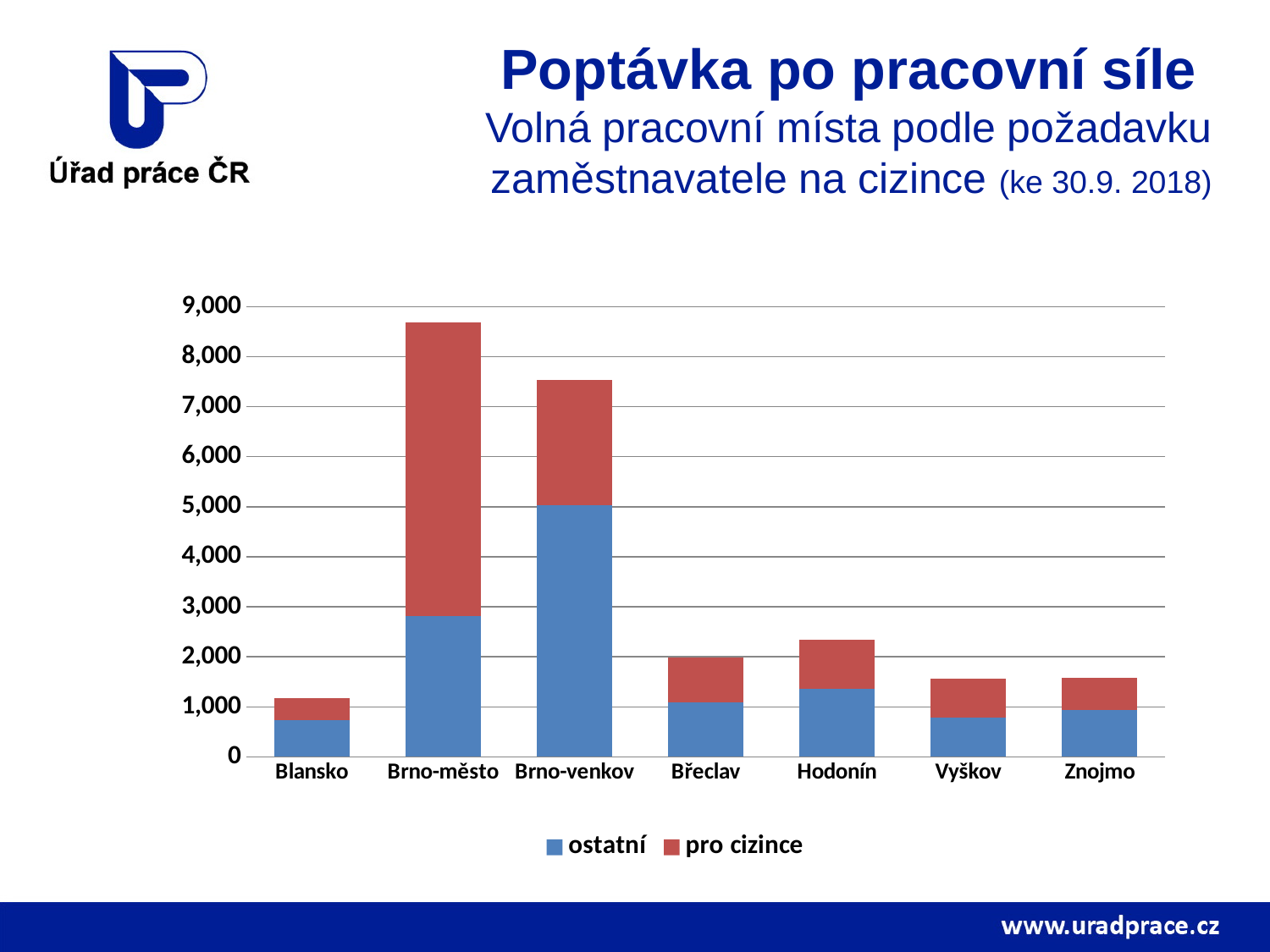
Is the total bar height for Brno-venkov greater or less than 7,000? greater Which is larger: the 'ostatní' segment for Brno-venkov or the 'ostatní' segment for Brno-město? Brno-venkov Which colour represents the 'pro cizince' series in the chart? red What kind of chart is shown on the slide? stacked bar chart Is the total bar height for Brno-město greater or less than 8,000? greater Which district has the tallest stacked bar (highest total of vacancies)? Brno-město Is the 'ostatní' value for Brno-venkov greater or less than 4,000? greater How many districts (categories) are shown on the x axis of the chart? 7 Which district has the largest 'ostatní' segment? Brno-venkov How many series does the chart legend list? 2 Which district has the largest 'pro cizince' segment? Brno-město Which district has the shortest stacked bar (lowest total of vacancies)? Blansko